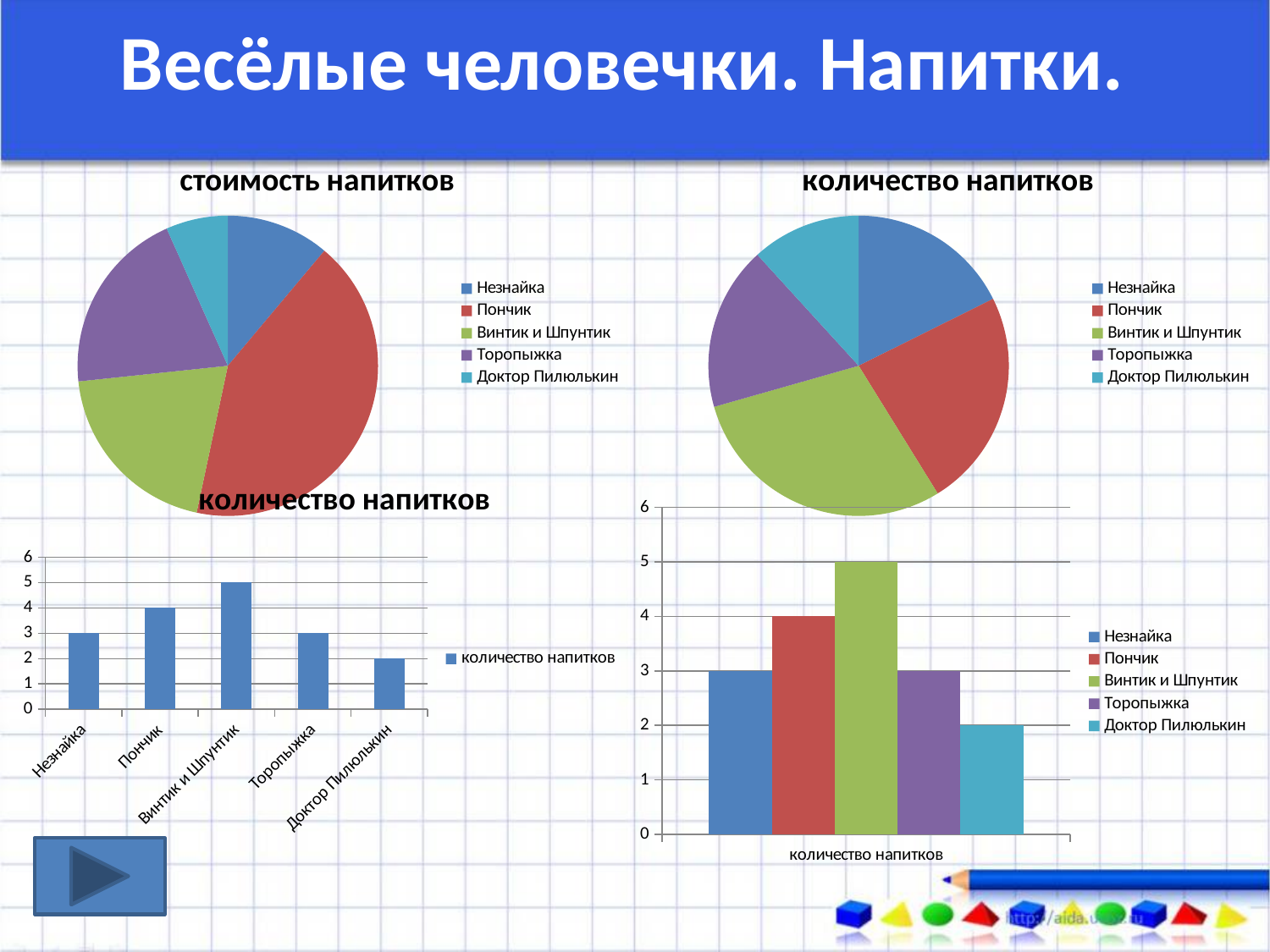
How many series does the legend of the bottom-right bar chart list? 5 In the bottom-left bar chart titled 'количество напитков', what is the value for Доктор Пилюлькин? 2 What kind of chart is the top-left chart titled 'стоимость напитков'? pie chart In the bottom-left bar chart titled 'количество напитков', what is the difference between the values for Винтик и Шпунтик and Доктор Пилюлькин? 3 In the bottom-right bar chart, which series has the lowest value? Доктор Пилюлькин In the bottom-right bar chart, which is larger: the value for Пончик or the value for Торопыжка? Пончик How many categories are shown in the bottom-left bar chart titled 'количество напитков'? 5 In the top-right pie chart titled 'количество напитков', which category has the smallest slice? Доктор Пилюлькин In the bottom-right bar chart, what is the value for Пончик? 4 In the bottom-left bar chart titled 'количество напитков', what is the value for Винтик и Шпунтик? 5 In the bottom-left bar chart titled 'количество напитков', which category has the highest value? Винтик и Шпунтик In the top-left pie chart titled 'стоимость напитков', which category has the largest slice? Пончик